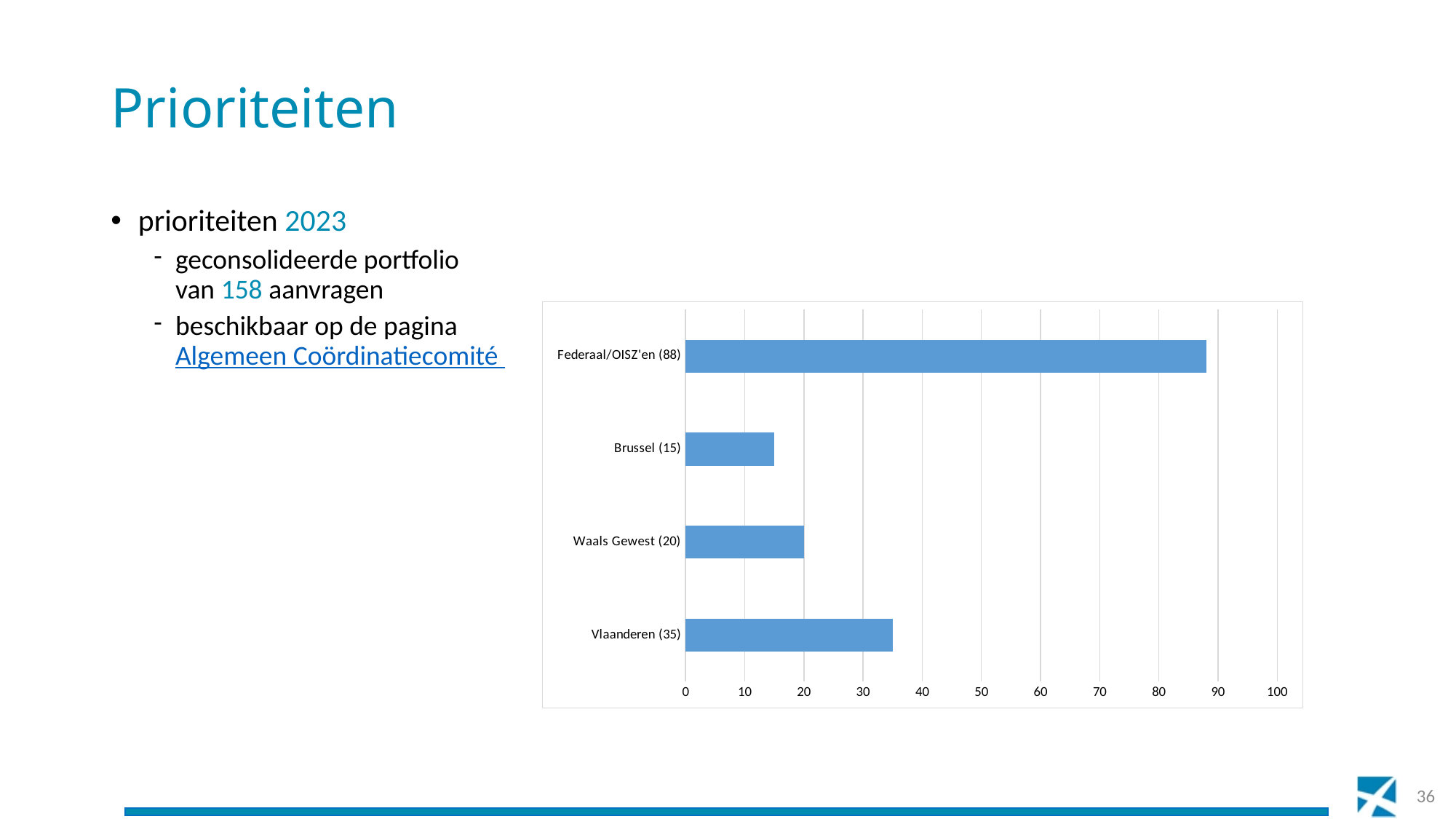
What is the value for Federaal/OISZ'en? 88 Which is larger, the value for Waals Gewest or the value for Brussel? Waals Gewest How many categories does the chart show? 4 What is the value for Brussel? 15 What is the total of the four values shown in the chart? 158 What is the difference between the values for Federaal/OISZ'en and Vlaanderen? 53 Which category has the lowest value? Brussel What is the value for Waals Gewest? 20 What is the value for Vlaanderen? 35 Which category has the highest value? Federaal/OISZ'en Is the value for Vlaanderen greater or less than 30? greater What kind of chart is shown on the slide? bar chart